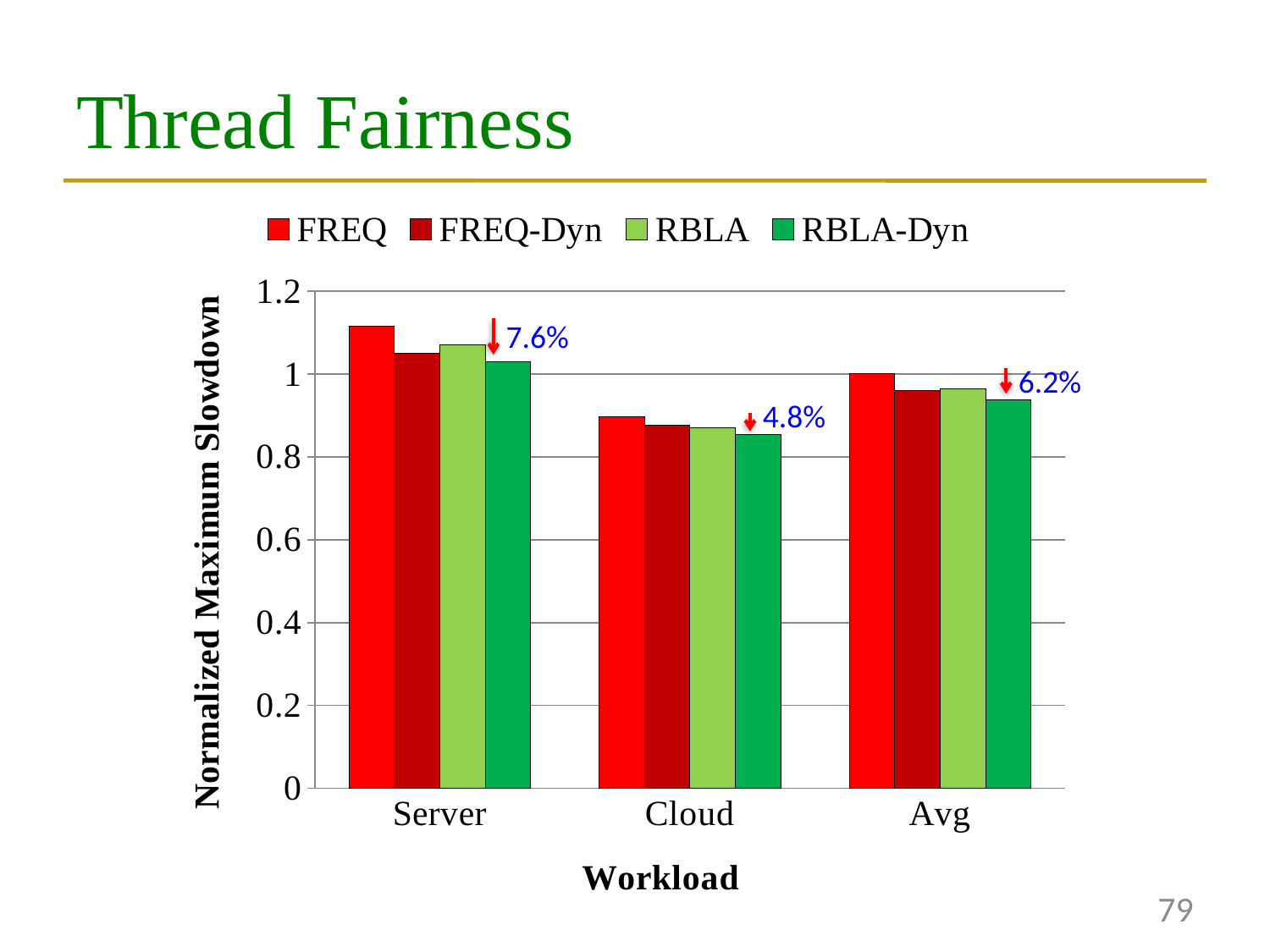
How many series does the legend list? 4 Which is larger, the FREQ value for Server or the FREQ value for Cloud? Server Within the Server workload, which is larger, the FREQ bar or the RBLA-Dyn bar? FREQ Is the RBLA-Dyn value for Cloud greater or less than 1? less How many workload categories are shown on the x axis? 3 What is the title of the y axis? Normalized Maximum Slowdown Which workload has the highest FREQ bar? Server Is the FREQ-Dyn value for Cloud greater or less than 0.8? greater What percentage reduction is annotated above the Server group? 7.6% What kind of chart is shown on the slide? bar chart Which workload has the lowest RBLA-Dyn bar? Cloud Is the FREQ value for Server greater or less than 1? greater